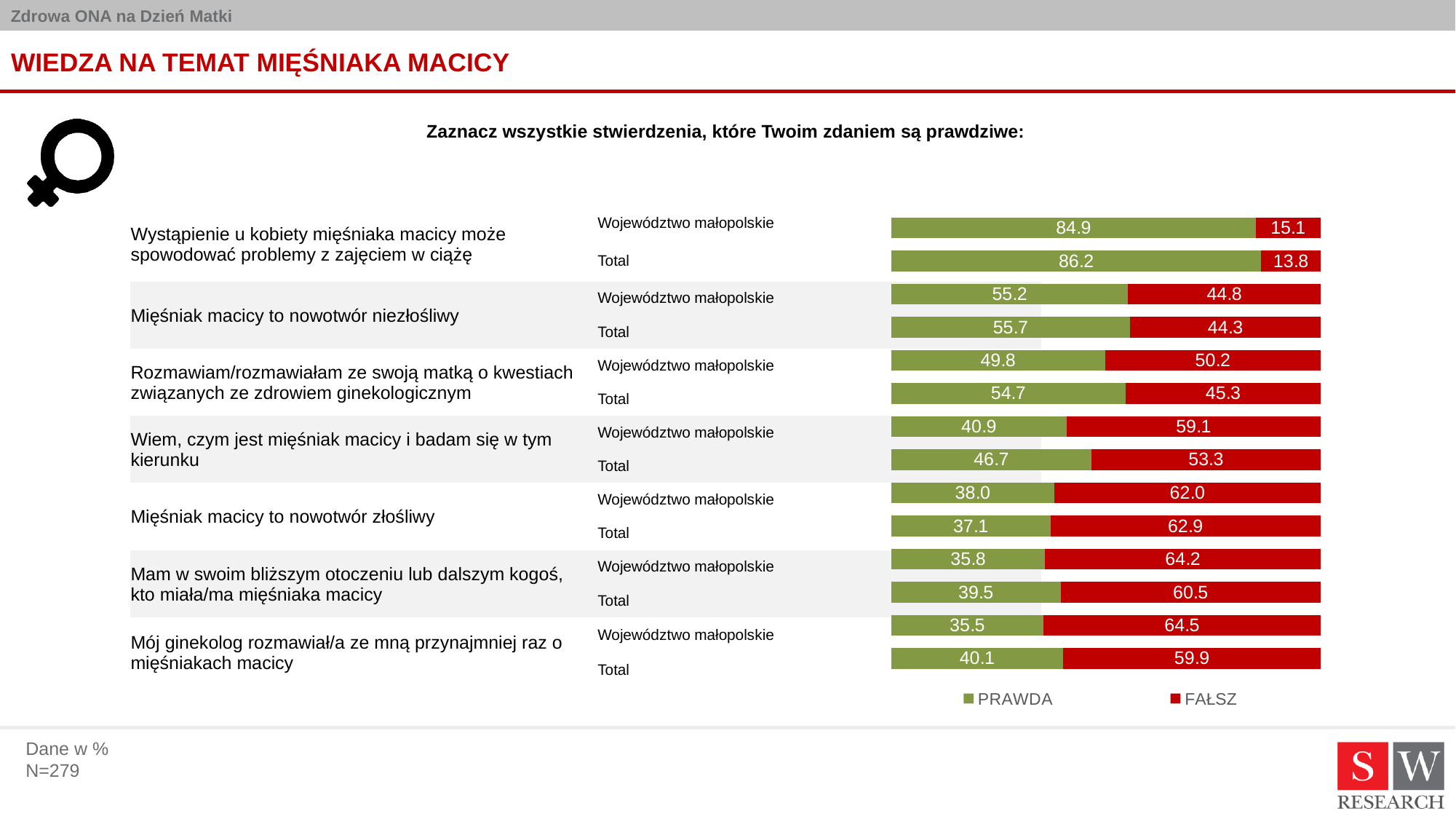
What is the total of the Województwo małopolskie bar for "Rozmawiam/rozmawiałam ze swoją matką o kwestiach związanych ze zdrowiem ginekologicznym"? 100 What is the FAŁSZ value for Total for the statement "Mięśniak macicy to nowotwór niezłośliwy"? 44.3 Which colour represents the FAŁSZ series in the chart? Red How many series does the legend list? 2 How many bars are plotted in the chart? 14 Which bar has the highest PRAWDA value? Total for "Wystąpienie u kobiety mięśniaka macicy może spowodować problemy z zajęciem w ciążę" (86.2) What is the difference between the Total and Województwo małopolskie PRAWDA values for "Wiem, czym jest mięśniak macicy i badam się w tym kierunku"? 5.8 Which bar has the lowest PRAWDA value? Województwo małopolskie for "Mój ginekolog rozmawiał/a ze mną przynajmniej raz o mięśniakach macicy" (35.5) What is the PRAWDA value for Województwo małopolskie for the statement "Wystąpienie u kobiety mięśniaka macicy może spowodować problemy z zajęciem w ciążę"? 84.9 What kind of chart is shown on the slide? Stacked bar chart What is the PRAWDA value for Total for the statement "Mój ginekolog rozmawiał/a ze mną przynajmniej raz o mięśniakach macicy"? 40.1 For the statement "Mięśniak macicy to nowotwór złośliwy", is the PRAWDA value larger for Województwo małopolskie or for Total? Województwo małopolskie